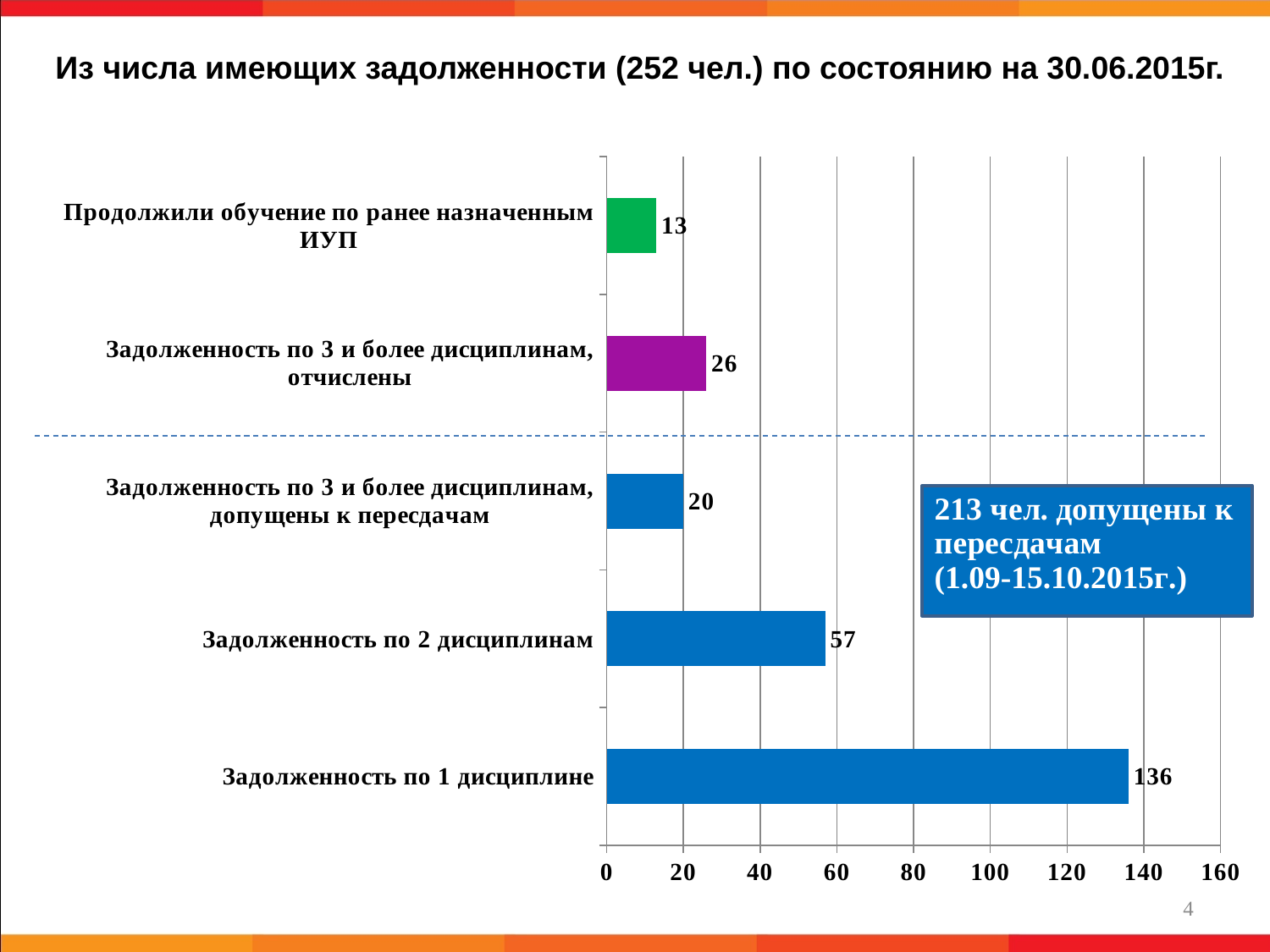
Which category has the highest value? Задолженность по 1 дисциплине What is the value for "Задолженность по 3 и более дисциплинам, отчислены"? 26 What is the value for "Задолженность по 2 дисциплинам"? 57 Which is larger: the value for "Задолженность по 3 и более дисциплинам, отчислены" or "Задолженность по 3 и более дисциплинам, допущены к пересдачам"? Задолженность по 3 и более дисциплинам, отчислены What kind of chart is shown on the slide? Bar chart How many categories are shown in the chart? 5 What is the value for "Задолженность по 3 и более дисциплинам, допущены к пересдачам"? 20 What is the difference between the values for "Задолженность по 1 дисциплине" and "Задолженность по 2 дисциплинам"? 79 What is the value for "Задолженность по 1 дисциплине"? 136 What is the value for "Продолжили обучение по ранее назначенным ИУП"? 13 Which category has the lowest value? Продолжили обучение по ранее назначенным ИУП What is the maximum value shown on the horizontal axis? 160